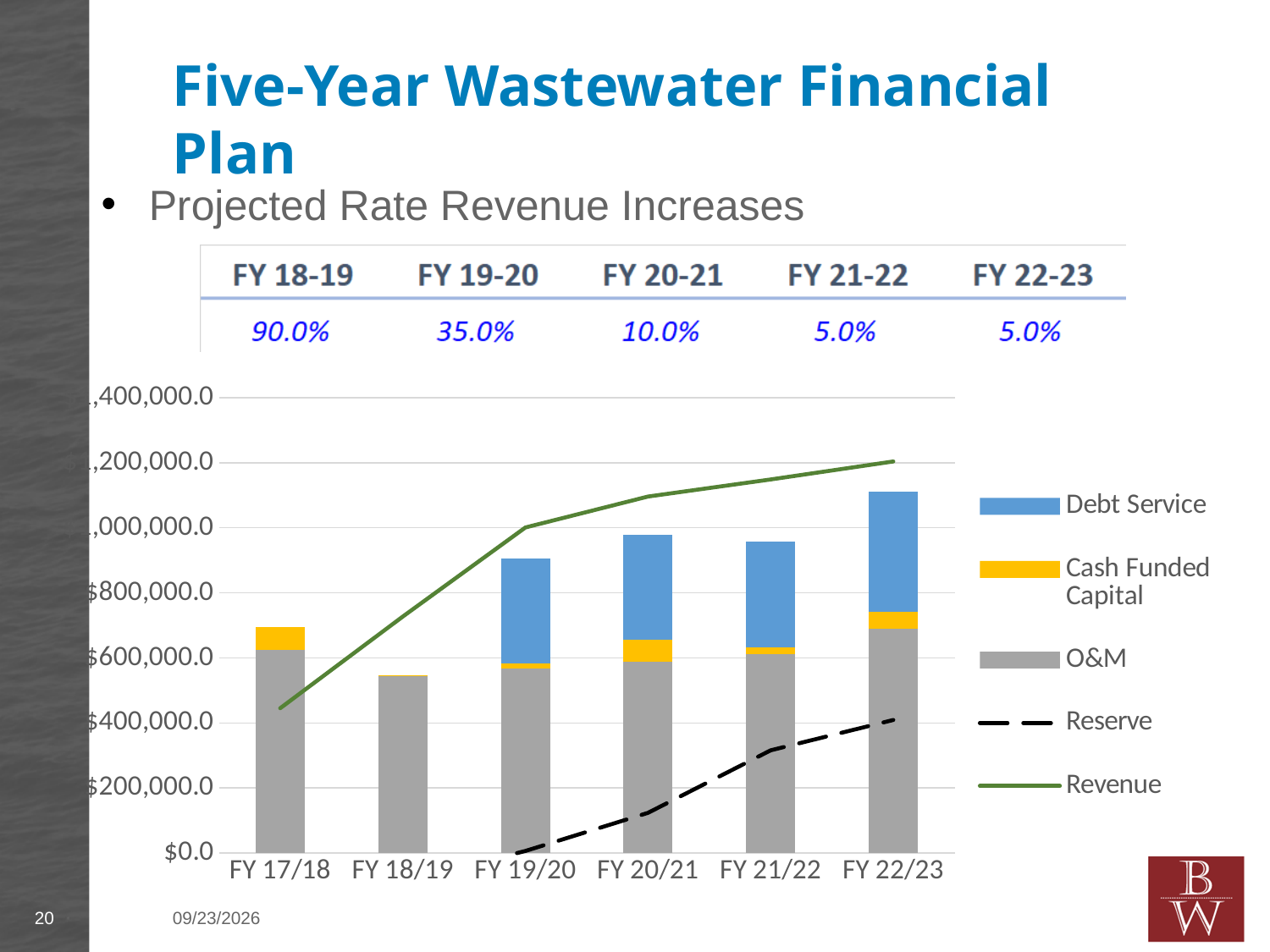
Which fiscal year has the shortest stacked bar? FY 18/19 Does the Revenue line rise or fall from FY 17/18 to FY 22/23? Rises Which series is drawn as a dashed black line in the chart? Reserve How many fiscal years are shown on the x axis of the chart? 6 Which fiscal year has the tallest stacked bar? FY 22/23 How many series does the chart legend list? 5 Is the Reserve value for FY 21/22 greater or less than $200,000.0? greater Which series forms the bottom (grey) segment of each stacked bar? O&M Is the total stacked bar for FY 18/19 greater or less than $600,000.0? less Which stacked bar is taller, FY 19/20 or FY 18/19? FY 19/20 What kind of chart is shown on the slide? A stacked bar chart combined with line series